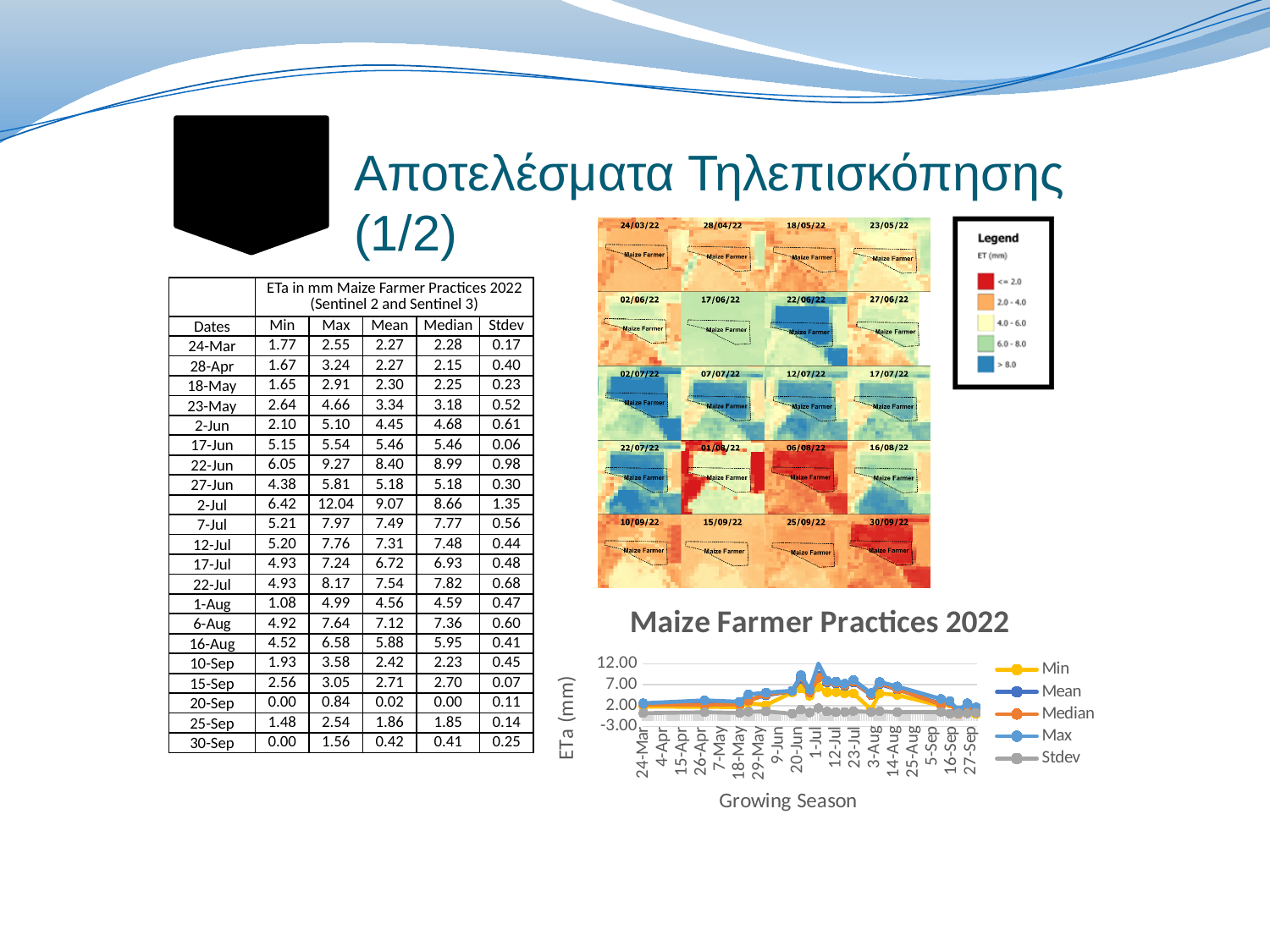
In the 'Maize Farmer Practices 2022' chart, which series stays lowest across the growing season? Stdev In the 'Maize Farmer Practices 2022' chart, is the Stdev series ever greater or less than 2.00? less In the 'Maize Farmer Practices 2022' chart, is the Mean value around 1-Jul greater or less than 7.00? greater In the 'Maize Farmer Practices 2022' chart, is the peak value of the Max series greater or less than 7.00? greater In the 'Maize Farmer Practices 2022' chart, do the Max values rise or fall from 24-Mar to 1-Jul? rise In the 'Maize Farmer Practices 2022' chart, is the Max series higher or lower than the Min series around 1-Jul? higher What is the label of the vertical axis of the 'Maize Farmer Practices 2022' chart? ETa (mm) What is the title of the chart on the slide? Maize Farmer Practices 2022 How many series does the legend of the 'Maize Farmer Practices 2022' chart list? 5 In the 'Maize Farmer Practices 2022' chart, which series reaches the highest value? Max What kind of chart is the 'Maize Farmer Practices 2022' chart? line chart In the 'Maize Farmer Practices 2022' chart, do the Mean values rise or fall from late June to late September? fall